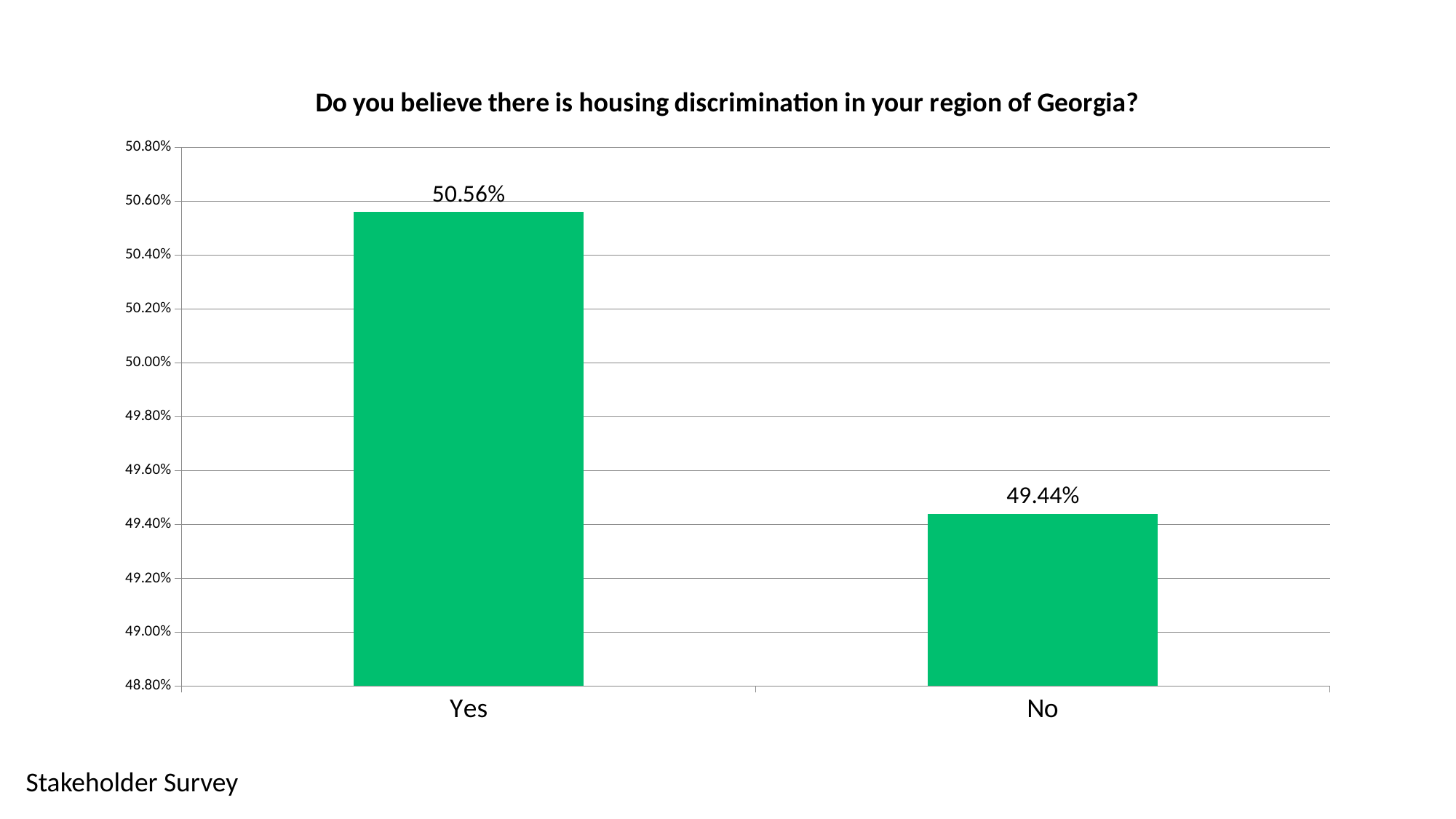
Which response has the higher percentage? Yes Is the value for Yes greater or less than 50.00%? greater What kind of chart is shown on the slide? bar chart Is the value for No greater or less than 49.60%? less What is the total of the Yes and No percentages? 100.00% What colour are the bars in the chart? green What percentage of respondents answered No? 49.44% What is the difference in percentage points between the Yes and No responses? 1.12% What percentage of respondents answered Yes? 50.56% What is the title of the chart? Do you believe there is housing discrimination in your region of Georgia? Which response has the lower percentage? No How many response categories are shown on the chart? 2